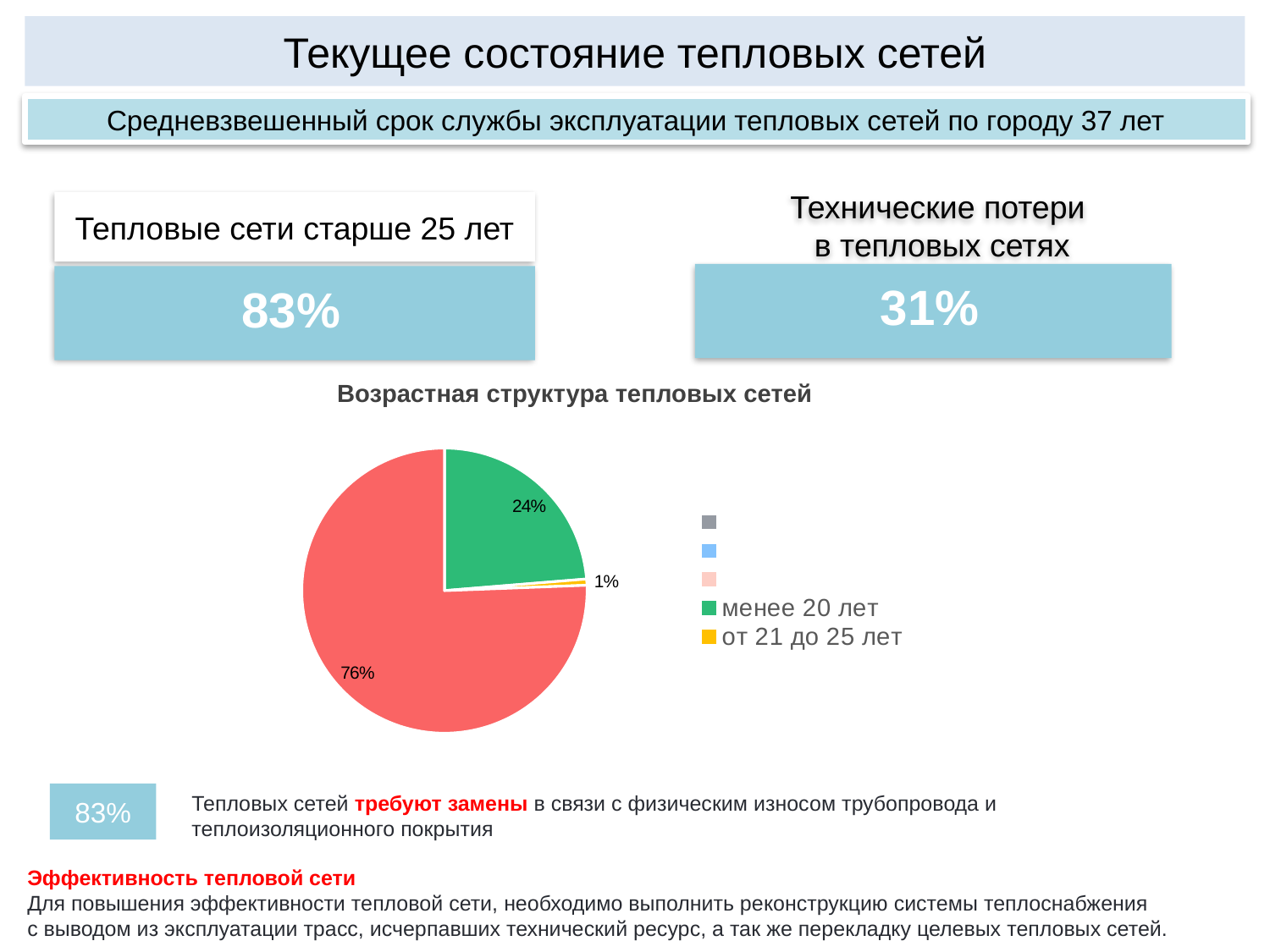
In the pie chart 'Возрастная структура тепловых сетей', which is larger: 'менее 20 лет' or 'от 21 до 25 лет'? менее 20 лет How many slices with data labels does the pie chart 'Возрастная структура тепловых сетей' have? 3 In the pie chart 'Возрастная структура тепловых сетей', what is the value of the largest slice? 76% What kind of chart is shown under the heading 'Возрастная структура тепловых сетей'? Pie chart In the pie chart 'Возрастная структура тепловых сетей', what share of the pie does 'менее 20 лет' take? 24% In the pie chart 'Возрастная структура тепловых сетей', which labelled category has the smallest slice? от 21 до 25 лет In the pie chart 'Возрастная структура тепловых сетей', what share is labelled for 'менее 20 лет'? 24% In the pie chart 'Возрастная структура тепловых сетей', what colour is the 'менее 20 лет' slice? Green In the pie chart 'Возрастная структура тепловых сетей', is the value for 'менее 20 лет' greater or less than 50%? less In the pie chart 'Возрастная структура тепловых сетей', what is the difference between the 'менее 20 лет' slice and the 'от 21 до 25 лет' slice? 23 percentage points In the pie chart 'Возрастная структура тепловых сетей', what share is labelled for 'от 21 до 25 лет'? 1% What is the title of the pie chart on the slide? Возрастная структура тепловых сетей